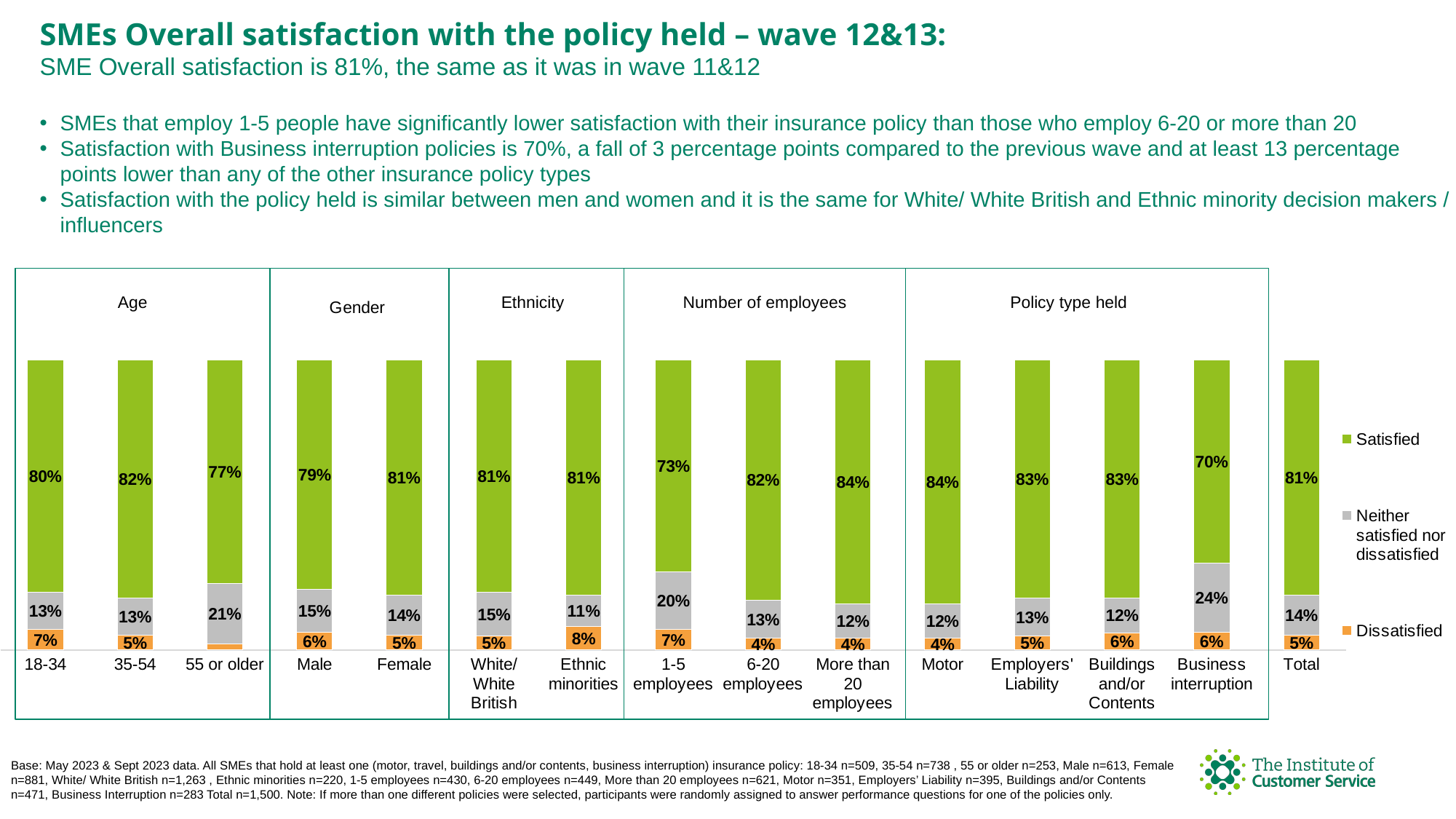
What is the Satisfied value for the Total bar? 81% What type of chart is shown on the slide? Stacked bar chart How many series does the legend list? 3 What is the 'Neither satisfied nor dissatisfied' value for Business interruption policies? 24% How many categories (bars) are shown in the chart? 15 What is the difference in Satisfied percentage between Motor and Business interruption? 14 percentage points What is the Dissatisfied value for Ethnic minorities? 8% What percentage of SMEs with 1-5 employees are satisfied with the policy held? 73% Which category has the lowest Satisfied percentage? Business interruption Which category has the highest 'Neither satisfied nor dissatisfied' percentage? Business interruption Which category has the highest Dissatisfied percentage? Ethnic minorities Which has a higher Satisfied percentage, 1-5 employees or More than 20 employees? More than 20 employees